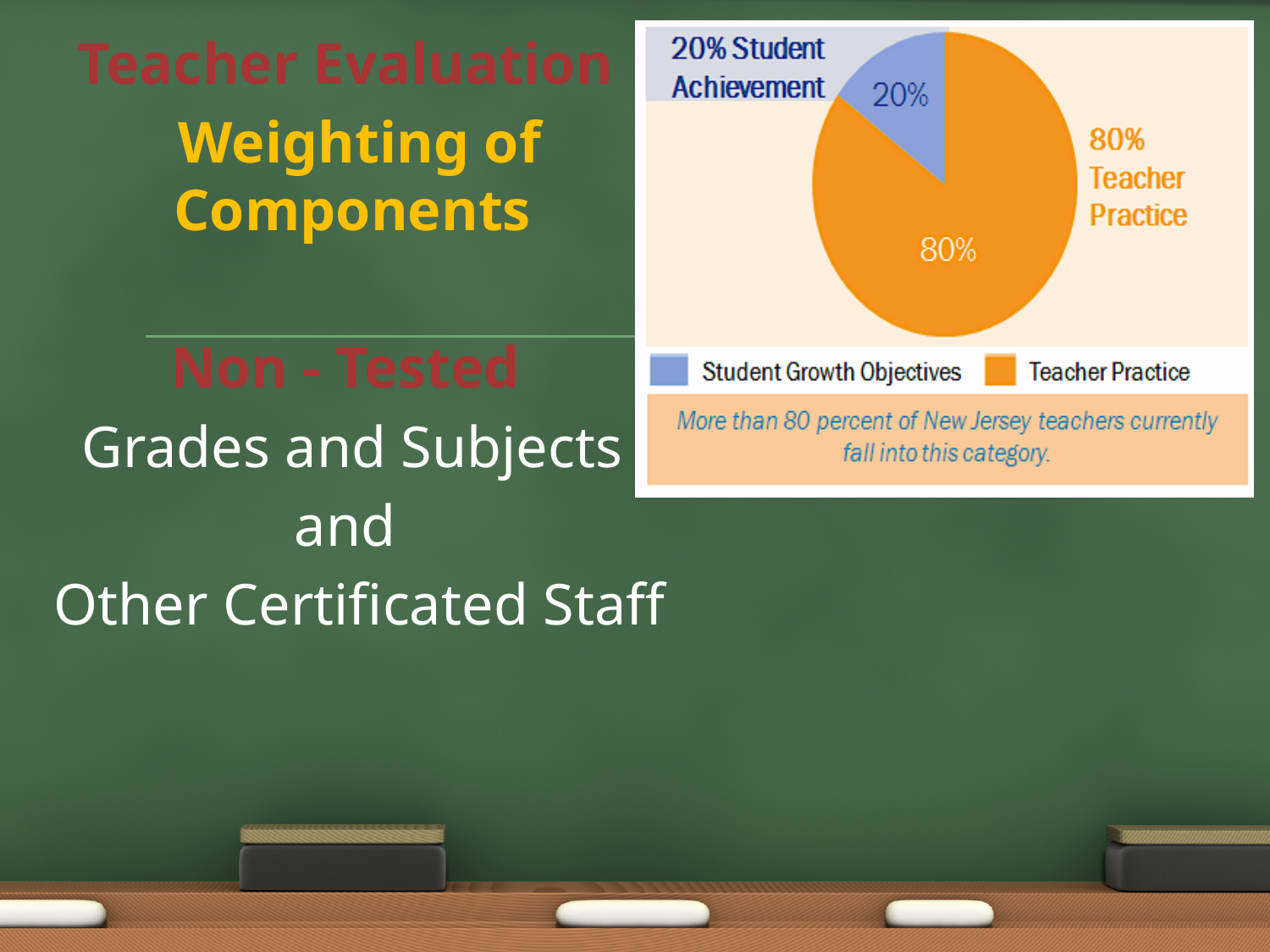
How many slices does the pie chart have? 2 What colour is the Teacher Practice slice? orange What kind of chart is shown on the slide? pie chart Which is larger, the Teacher Practice slice or the Student Growth Objectives slice? Teacher Practice What is the total of the two slices shown in the pie chart? 100% Which slice of the pie is the largest? Teacher Practice What share of the pie does Student Achievement (Student Growth Objectives) represent? 20% How many entries does the legend list? 2 What share of the pie does Teacher Practice represent? 80% What is the difference in percentage points between the Teacher Practice slice and the Student Achievement slice? 60 What colour is the Student Growth Objectives slice? blue Which slice of the pie is the smallest? Student Growth Objectives